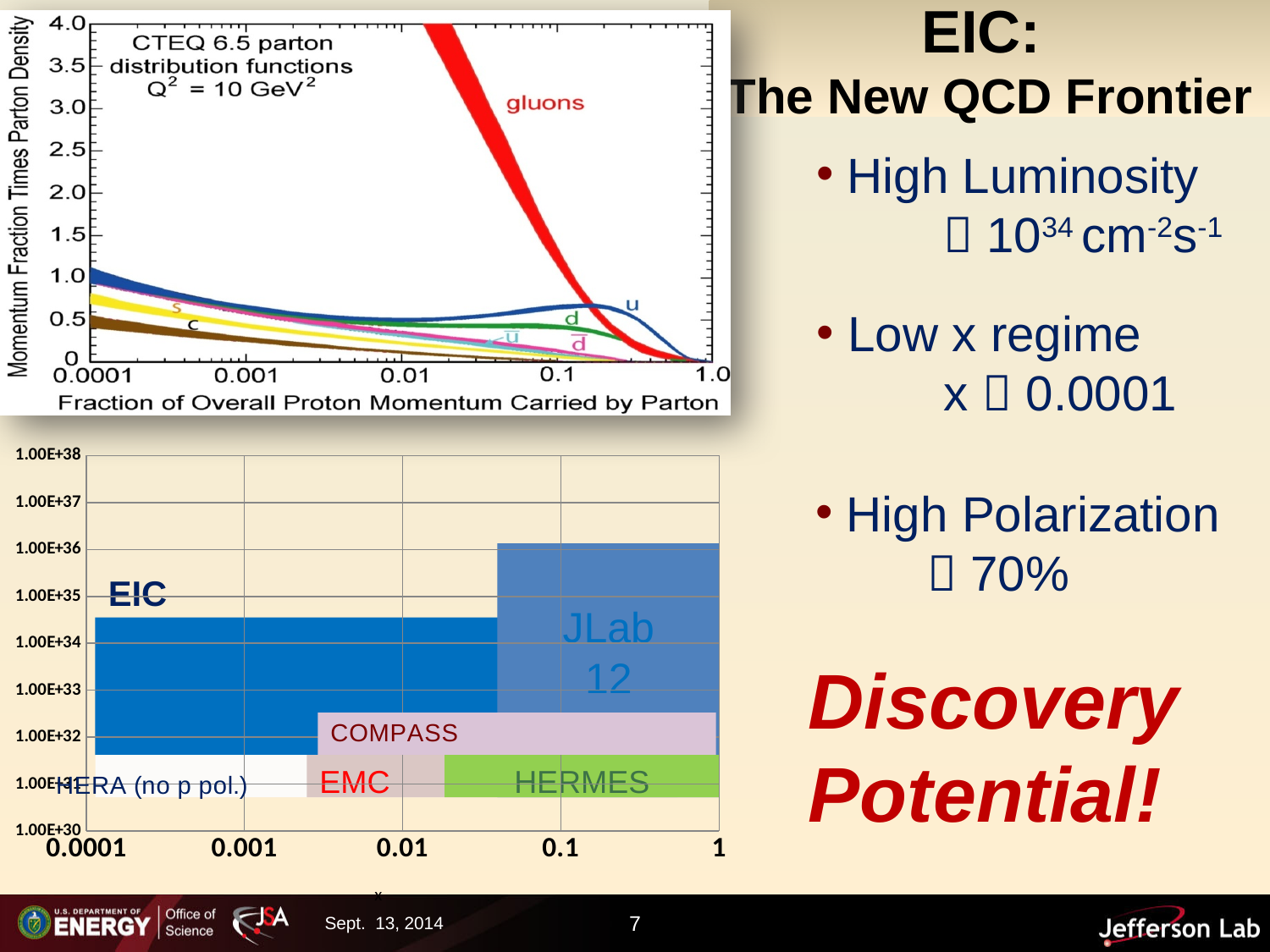
In the bottom chart, is the top of the JLab 12 region greater or less than 1.00E+35? greater In the top chart, which curve is higher at x = 0.1, u or c? u In the top chart, how many labeled parton curves are shown? 7 In the top chart, which labeled curve is highest at x = 0.01? gluons In the bottom chart, which labeled region reaches the highest value on the y axis? JLab 12 In the top chart, what is the title printed inside the plot area? CTEQ 6.5 parton distribution functions Q² = 10 GeV² In the bottom chart, how many labeled experiment regions are shown? 6 In the top chart, does the gluons curve rise or fall as x increases? fall In the bottom chart, is the top of the HERMES region greater or less than 1.00E+32? less In the top chart, what is the maximum value shown on the y axis? 4.0 In the top chart, what is the label of the y axis? Momentum Fraction Times Parton Density